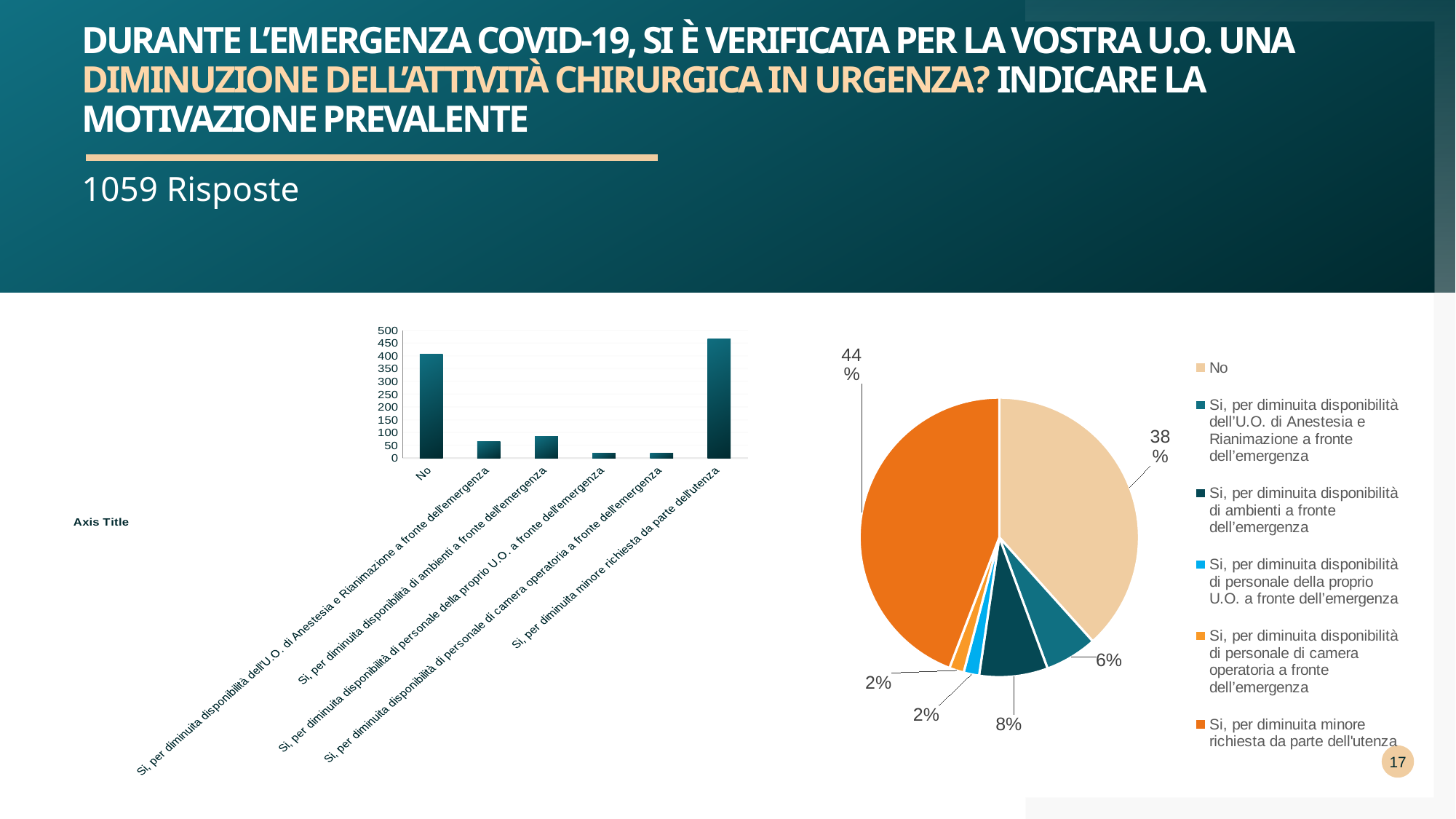
In the bar chart on the left, which is larger: the bar for 'No' or the bar for 'Si, per diminuita disponibilità dell'U.O. di Anestesia e Rianimazione a fronte dell'emergenza'? No In the pie chart on the right, what share of responses is 'Si, per diminuita minore richiesta da parte dell'utenza'? 44% In the bar chart on the left, is the value for 'Si, per diminuita disponibilità di ambienti a fronte dell'emergenza' greater or less than 150? less In the pie chart on the right, which category has the largest slice? Si, per diminuita minore richiesta da parte dell'utenza In the bar chart on the left, which category has the tallest bar? Si, per diminuita minore richiesta da parte dell'utenza In the pie chart on the right, what share of responses is 'No'? 38% What kind of chart is shown on the left of the slide? Bar chart In the pie chart on the right, how many categories does the legend list? 6 In the pie chart on the right, what share of responses is 'Si, per diminuita disponibilità di ambienti a fronte dell'emergenza'? 8% In the pie chart on the right, what is the difference in percentage points between the 'No' slice and the 'Si, per diminuita disponibilità di ambienti a fronte dell'emergenza' slice? 30 percentage points In the bar chart on the left, is the value for 'No' greater or less than 350? greater